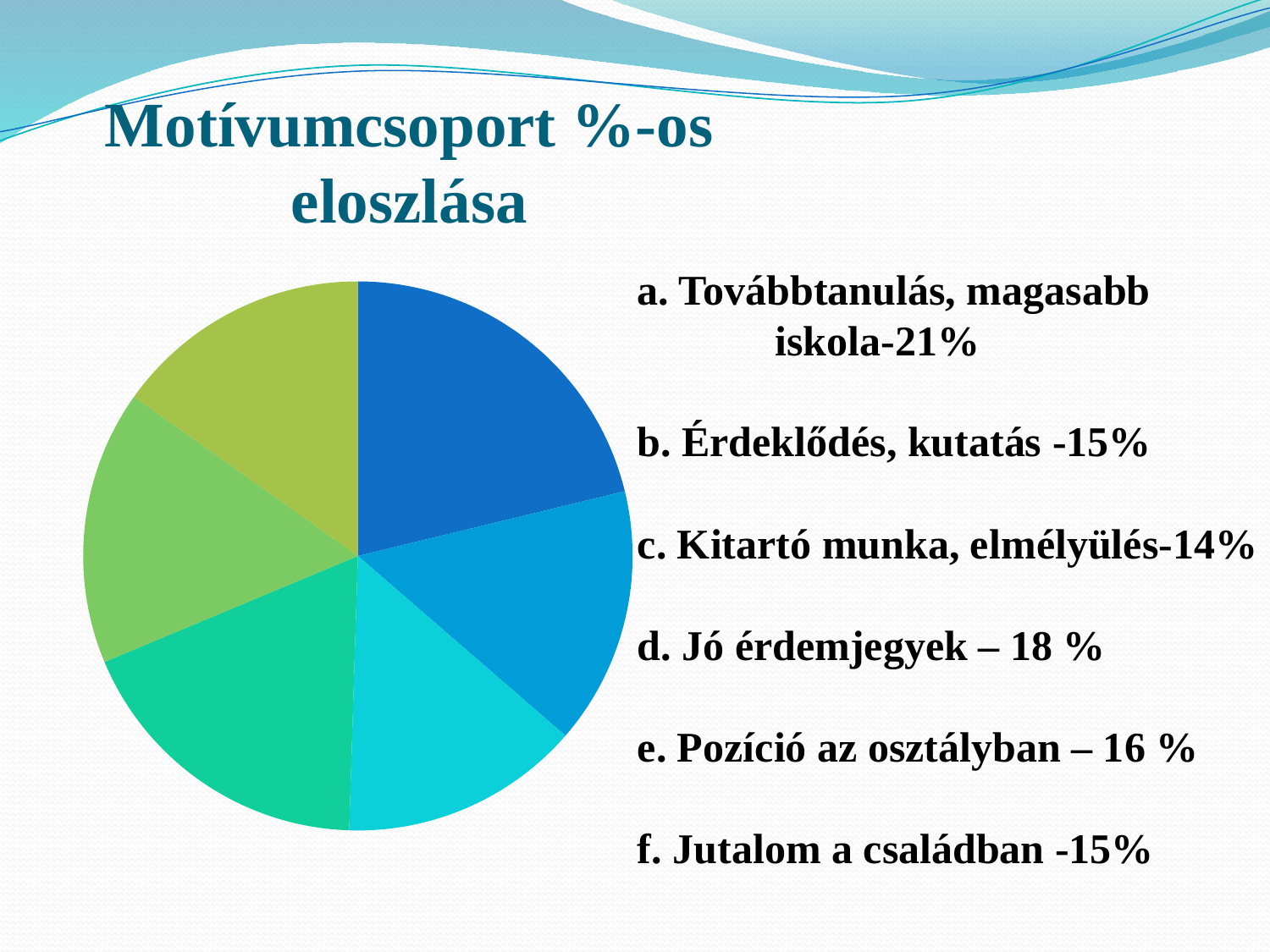
Which motive group has the smallest share of the pie? Kitartó munka, elmélyülés Which motive group has the largest share of the pie? Továbbtanulás, magasabb iskola Which has a larger share: 'Jó érdemjegyek' or 'Pozíció az osztályban'? Jó érdemjegyek What kind of chart is shown on the slide? pie chart What percentage is given for 'Pozíció az osztályban'? 16 % What percentage is given for 'Jó érdemjegyek'? 18 % What percentage is given for 'Kitartó munka, elmélyülés'? 14% What percentage is given for 'Érdeklődés, kutatás'? 15% What is the title of the chart on the slide? Motívumcsoport %-os eloszlása How many slices does the pie chart have? 6 What is the difference in percentage points between 'Továbbtanulás, magasabb iskola' and 'Kitartó munka, elmélyülés'? 7 What percentage is given for 'Továbbtanulás, magasabb iskola'? 21%